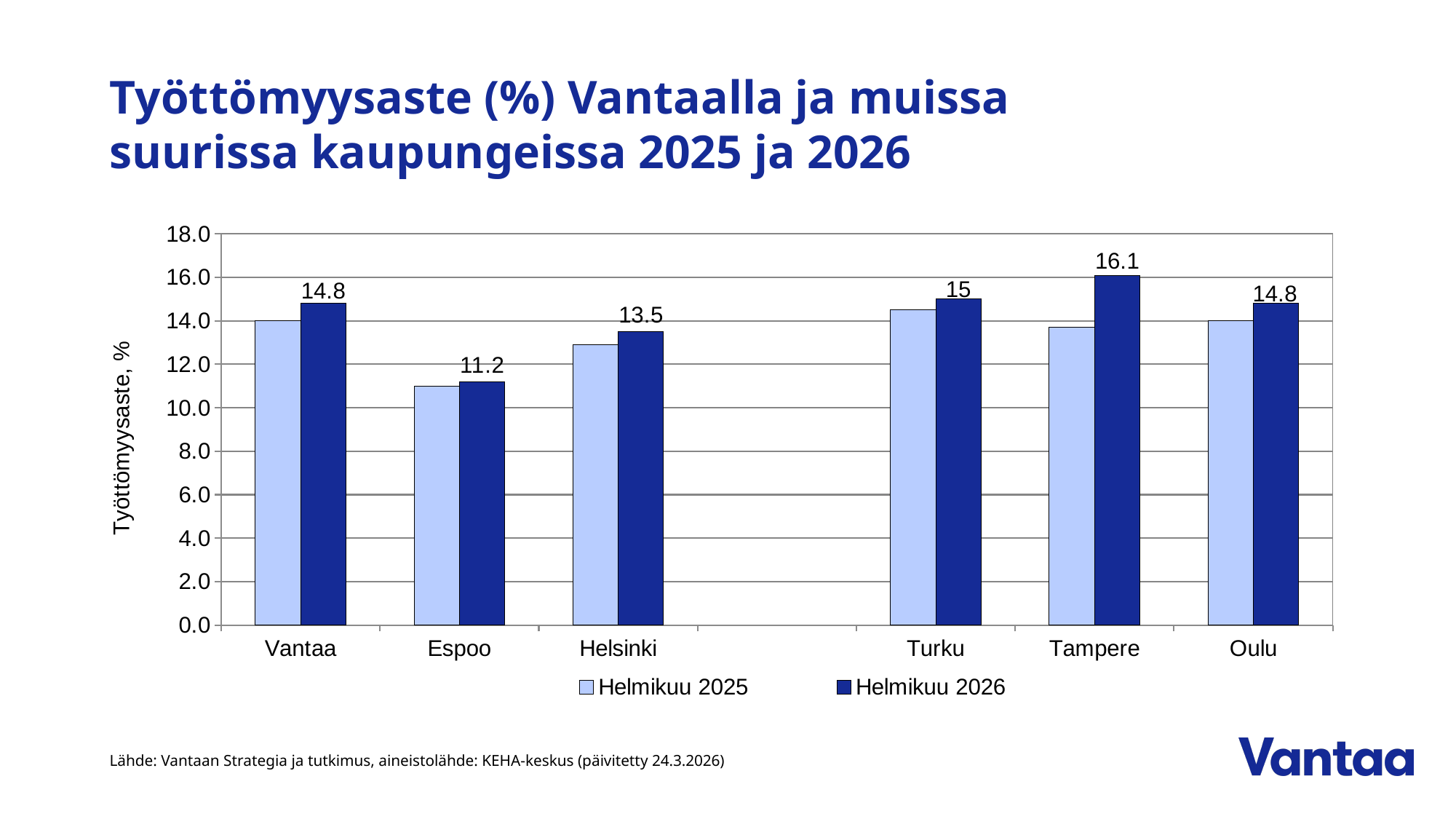
Which city has the lowest unemployment rate in Helmikuu 2026? Espoo What is the unemployment rate for Helsinki in Helmikuu 2026? 13.5 What kind of chart is shown on the slide? Bar chart Which city has the highest unemployment rate in Helmikuu 2026? Tampere What is the unemployment rate for Tampere in Helmikuu 2026? 16.1 Is the Helmikuu 2025 value for Helsinki greater or less than 12.0? greater Which has a higher unemployment rate in Helmikuu 2026, Turku or Helsinki? Turku What is the difference between the Helmikuu 2026 unemployment rates of Tampere and Espoo? 4.9 What is the unemployment rate for Vantaa in Helmikuu 2026? 14.8 What is the unemployment rate for Espoo in Helmikuu 2026? 11.2 How many cities are shown on the x axis of the chart? 6 How many series does the legend list? 2